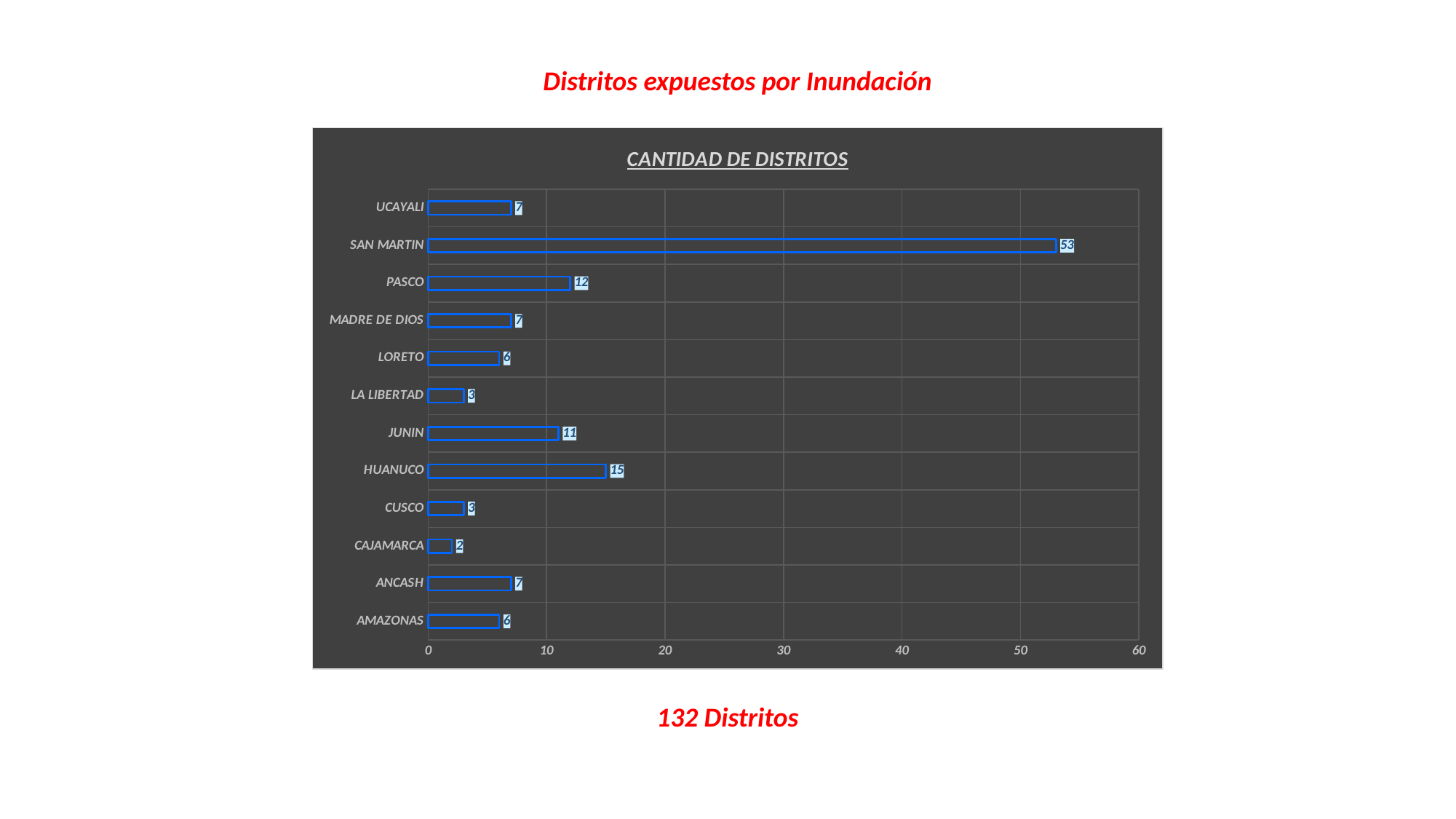
Is the value for SAN MARTIN greater or less than 50? greater What is the value for PASCO? 12 Which is larger, the value for JUNIN or the value for PASCO? PASCO How many categories are shown on the chart? 12 What is the value for SAN MARTIN? 53 What kind of chart is shown? bar chart What is the value for CAJAMARCA? 2 What is the title of the chart? CANTIDAD DE DISTRITOS Which category has the highest value? SAN MARTIN What is the difference between the values for SAN MARTIN and HUANUCO? 38 What is the value for HUANUCO? 15 Which category has the lowest value? CAJAMARCA